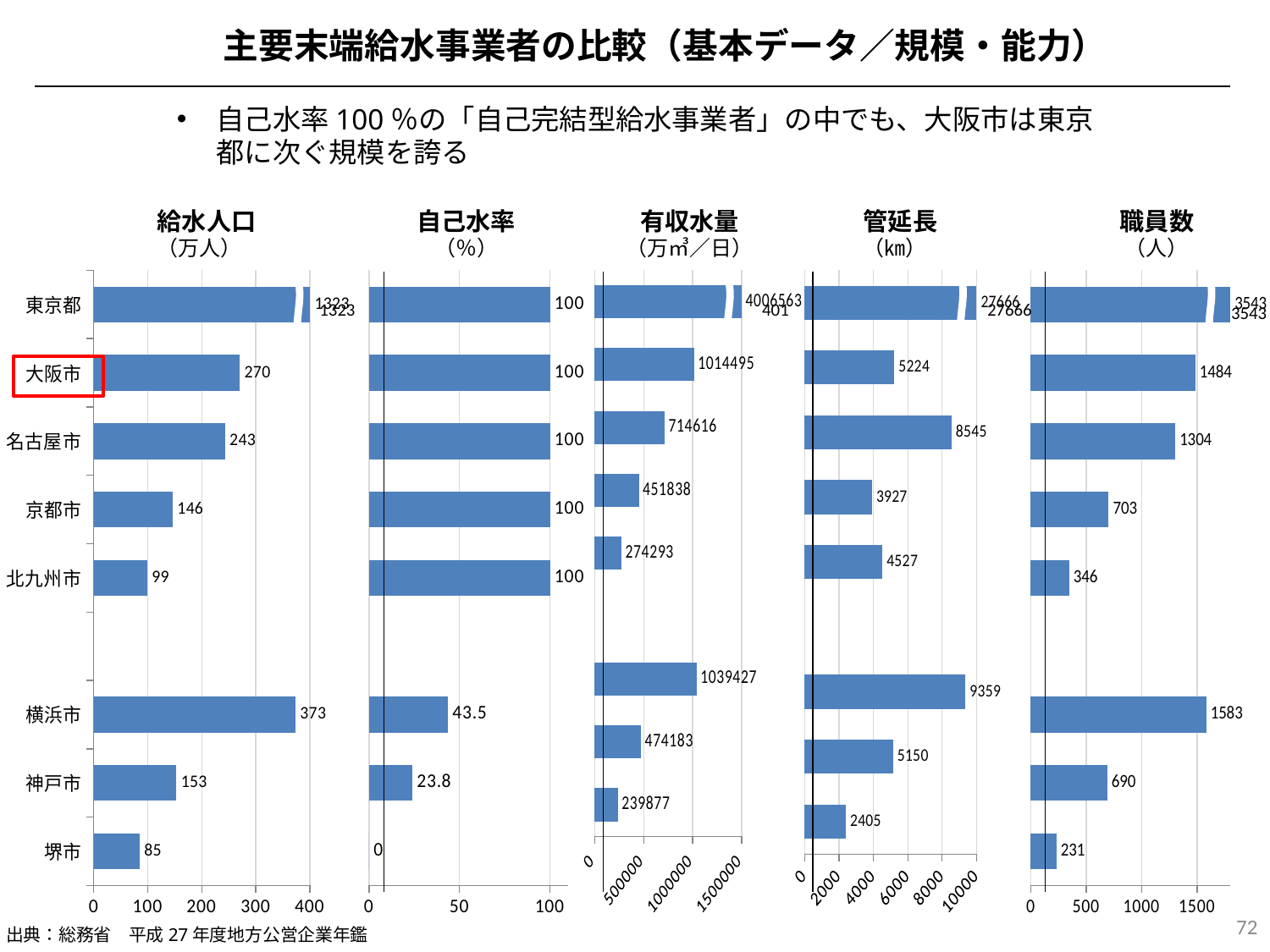
In the 自己水率 chart, what is the value for 横浜市? 43.5 In the 自己水率 chart, what is the value for 神戸市? 23.8 In the 職員数 chart, what is the difference between the values for 大阪市 and 名古屋市? 180 What kind of chart is the 職員数 chart? bar chart In the 給水人口 chart, which category has the lowest value? 堺市 In the 有収水量 chart, what is the value for 大阪市? 1014495 How many categories are shown in the 給水人口 chart? 8 In the 給水人口 chart, which category has the highest value? 東京都 In the 職員数 chart, what is the value for 堺市? 231 In the 管延長 chart, which is larger, the value for 横浜市 or the value for 大阪市? 横浜市 In the 管延長 chart, what is the value for 名古屋市? 8545 In the 給水人口 chart, what is the value for 大阪市? 270